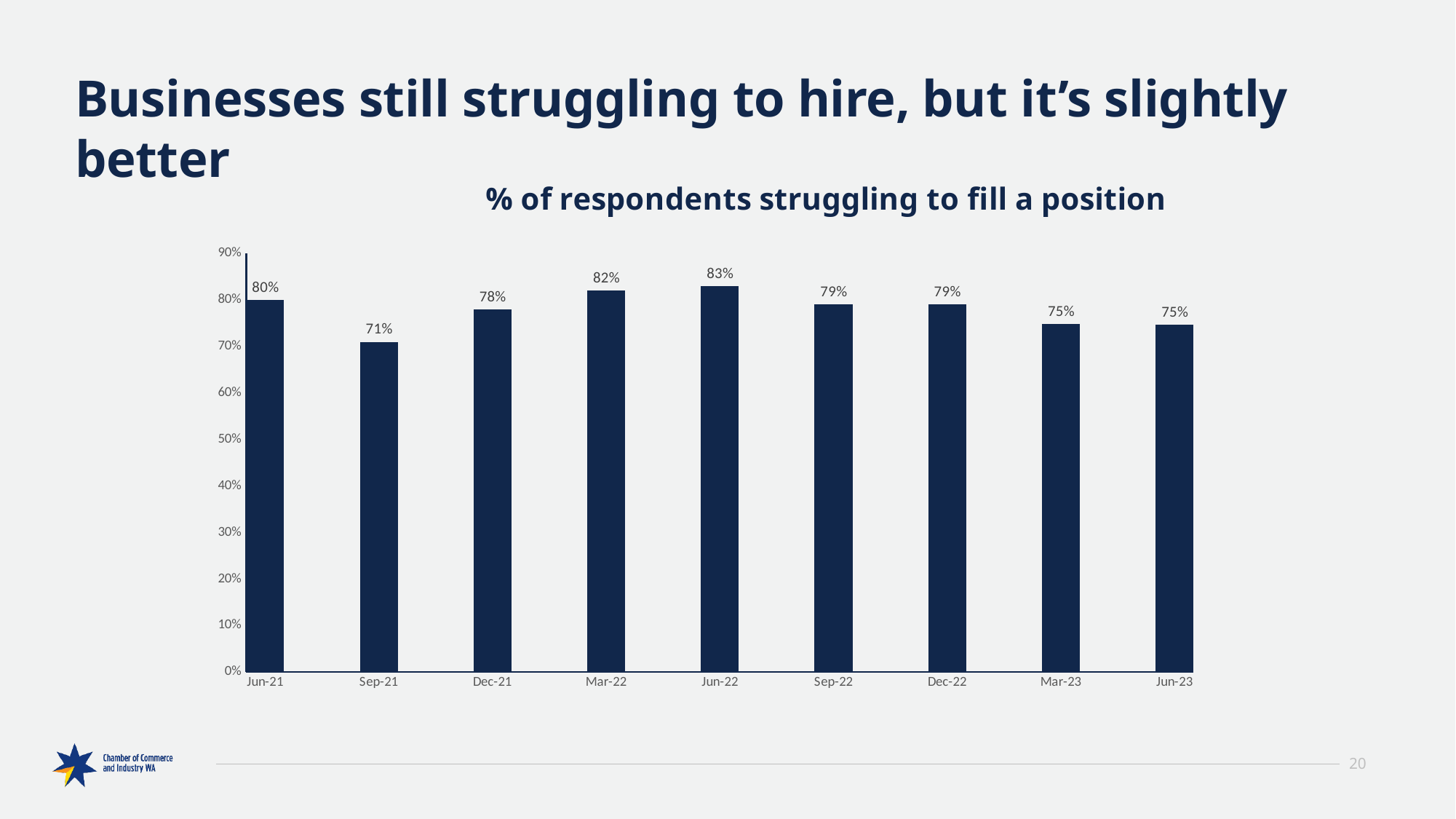
Which period has the lowest percentage of respondents struggling to fill a position? Sep-21 What is the value for Jun-23? 75% What is the title of the chart? % of respondents struggling to fill a position What is the difference between the values for Jun-22 and Jun-23? 8% Is the value for Dec-22 greater or less than 70%? greater What kind of chart is shown on the slide? Bar chart How many periods are shown on the x axis? 9 Which period has the highest percentage of respondents struggling to fill a position? Jun-22 What is the value for Sep-21? 71% What is the difference between the values for Jun-21 and Sep-21? 9% What is the value for Jun-22? 83% Which is larger, the value for Mar-22 or the value for Dec-21? Mar-22